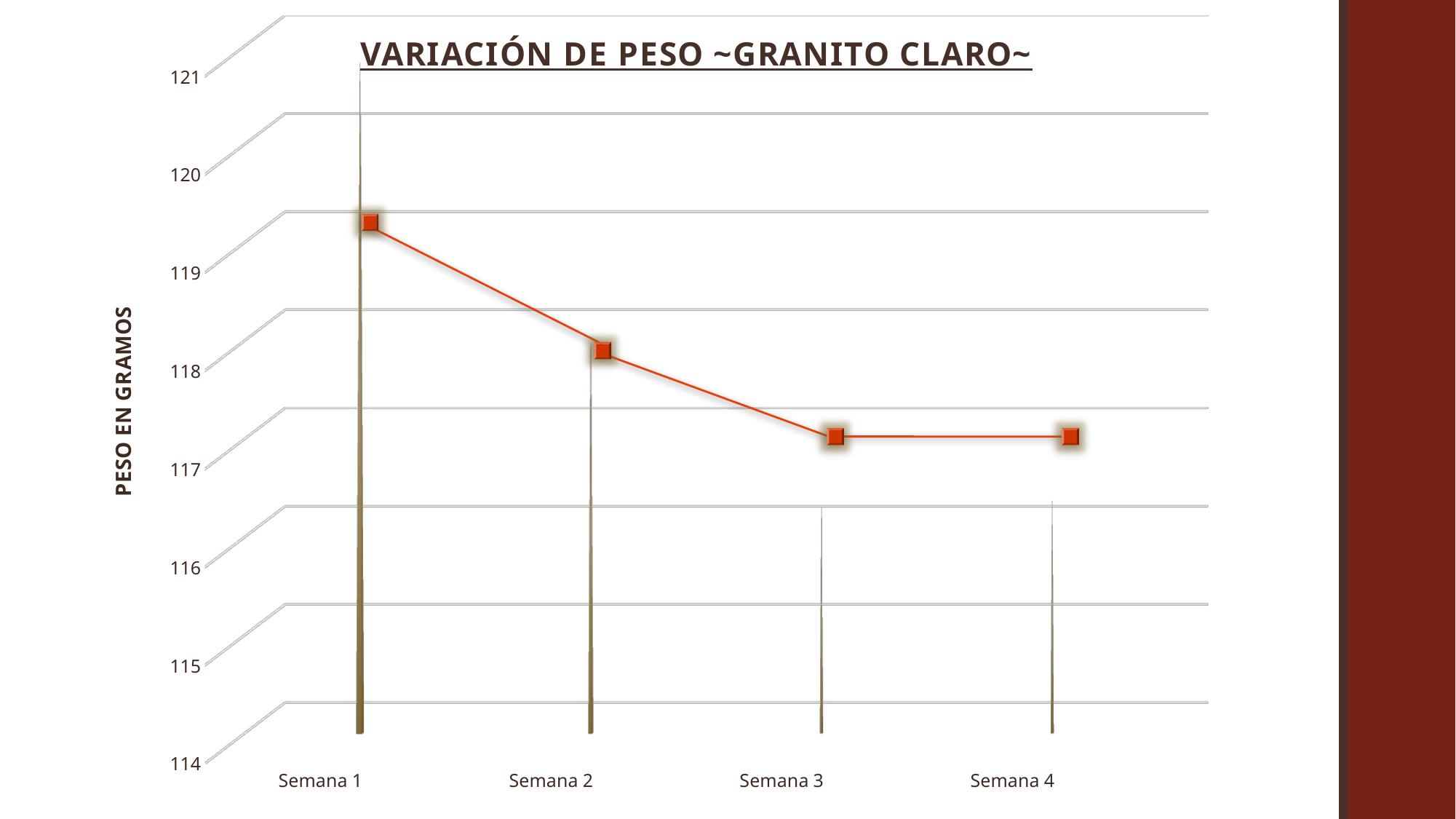
What is the label of the vertical axis? PESO EN GRAMOS Do the values generally rise or fall from Semana 1 to Semana 4? fall Which is larger, the value for Semana 1 or the value for Semana 2? Semana 1 Is the value for Semana 1 greater or less than 119? greater How many weeks (categories) are plotted on the x axis? 4 Is the value for Semana 2 greater or less than 118? greater Is the value for Semana 1 greater or less than 120? less Which week has the highest weight? Semana 1 What kind of chart is shown on the slide? line chart What is the title of the chart? VARIACIÓN DE PESO ~GRANITO CLARO~